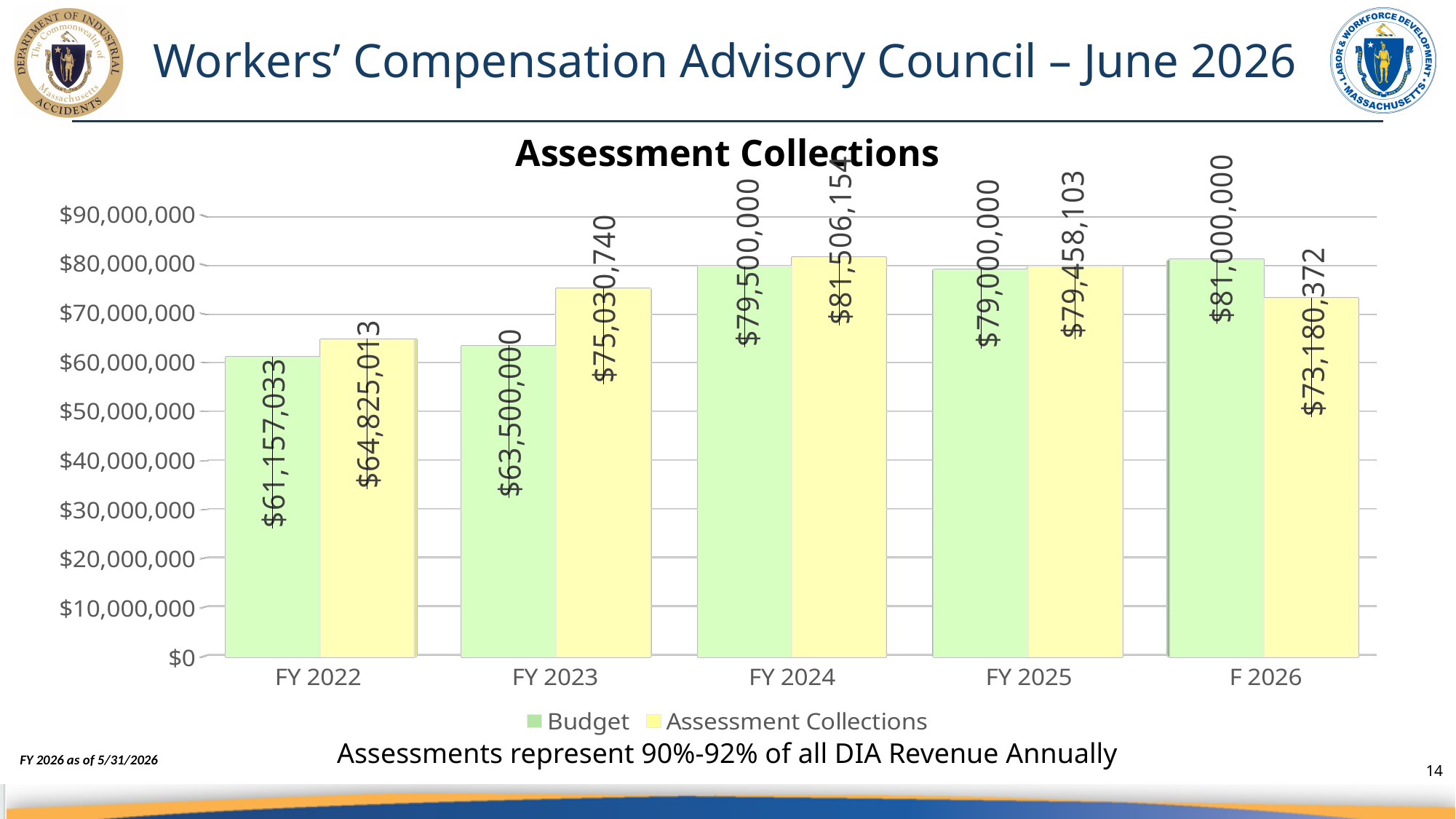
What is the difference between Assessment Collections and Budget in FY 2023? $11,530,740 How many fiscal years are shown on the x axis? 5 What is the Assessment Collections value for F 2026? $73,180,372 What is the title of the chart? Assessment Collections What is the Budget value for FY 2025? $79,000,000 What type of chart is shown on the slide? Bar chart In F 2026, which is larger: Budget or Assessment Collections? Budget Is the Budget value for FY 2022 greater or less than $70,000,000? less Which fiscal year has the highest Assessment Collections value? FY 2024 How many series does the legend list? 2 Which fiscal year has the lowest Budget value? FY 2022 What is the Assessment Collections value for FY 2023? $75,030,740